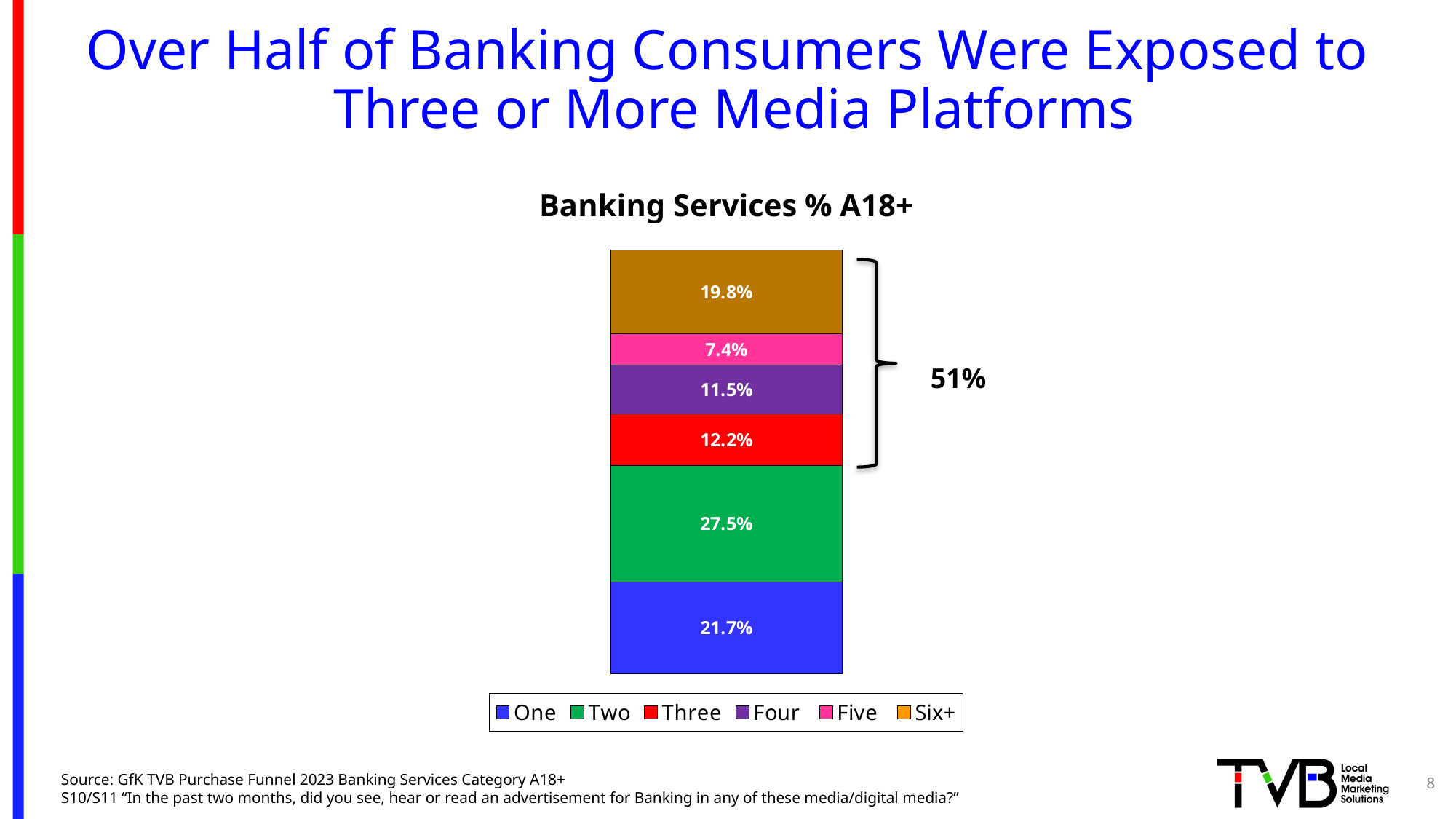
What is the value for the "Two" segment in the Banking Services % A18+ chart? 27.5% Which segment has the smallest value in the Banking Services % A18+ chart? Five What kind of chart is shown on the slide? Stacked bar chart What is the value for the "Five" segment in the Banking Services % A18+ chart? 7.4% What is the value for the "One" segment in the Banking Services % A18+ chart? 21.7% What is the value for the "Six+" segment in the Banking Services % A18+ chart? 19.8% What is the difference between the "Two" and "One" segments in the Banking Services % A18+ chart? 5.8% How many series does the legend list in the Banking Services % A18+ chart? 6 Which segment has the largest value in the Banking Services % A18+ chart? Two Which is larger in the Banking Services % A18+ chart, the "Three" segment or the "Four" segment? Three What colour is the "Two" segment in the Banking Services % A18+ chart? Green What combined percentage does the bracket on the right of the bar indicate for the Three, Four, Five and Six+ segments? 51%